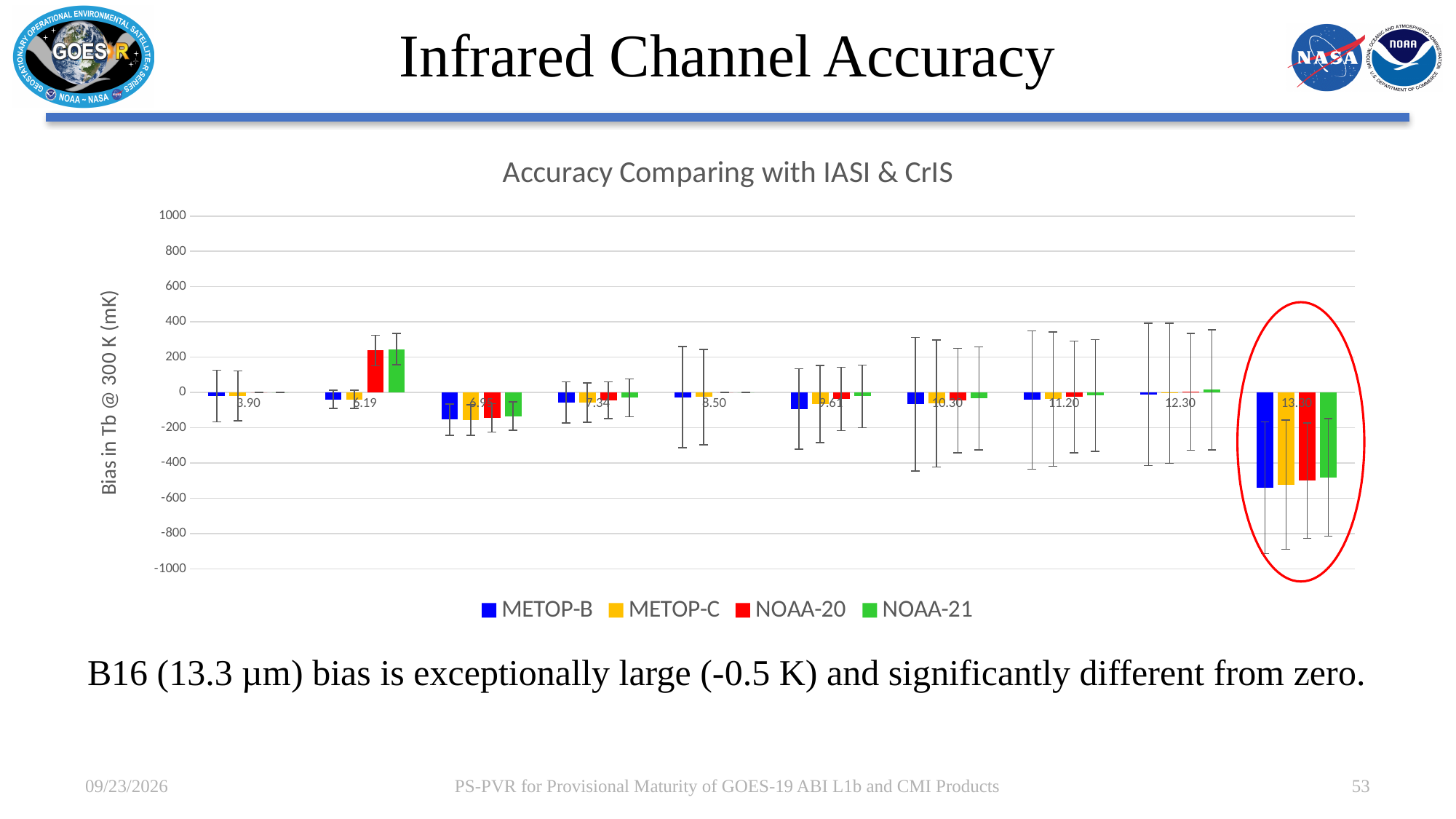
Is the NOAA-20 value for the 6.19 category greater or less than 100? greater How many category groups are plotted along the x axis of the chart? 10 What kind of chart is shown on the slide? bar chart Which category has the highest positive bias values in the chart? 6.19 What is the label of the vertical axis of the chart? Bias in Tb @ 300 K (mK) Is the METOP-C value for the 3.90 category greater or less than 200? less For the 6.19 category, which is larger: the NOAA-20 value or the METOP-B value? NOAA-20 Which category group shows the most negative bias values for all four series? the rightmost (circled) group, 13.3 µm Is the METOP-B value in the rightmost (circled) group greater or less than -400? less How many series does the legend of the chart list? 4 What is the title of the chart? Accuracy Comparing with IASI & CrIS